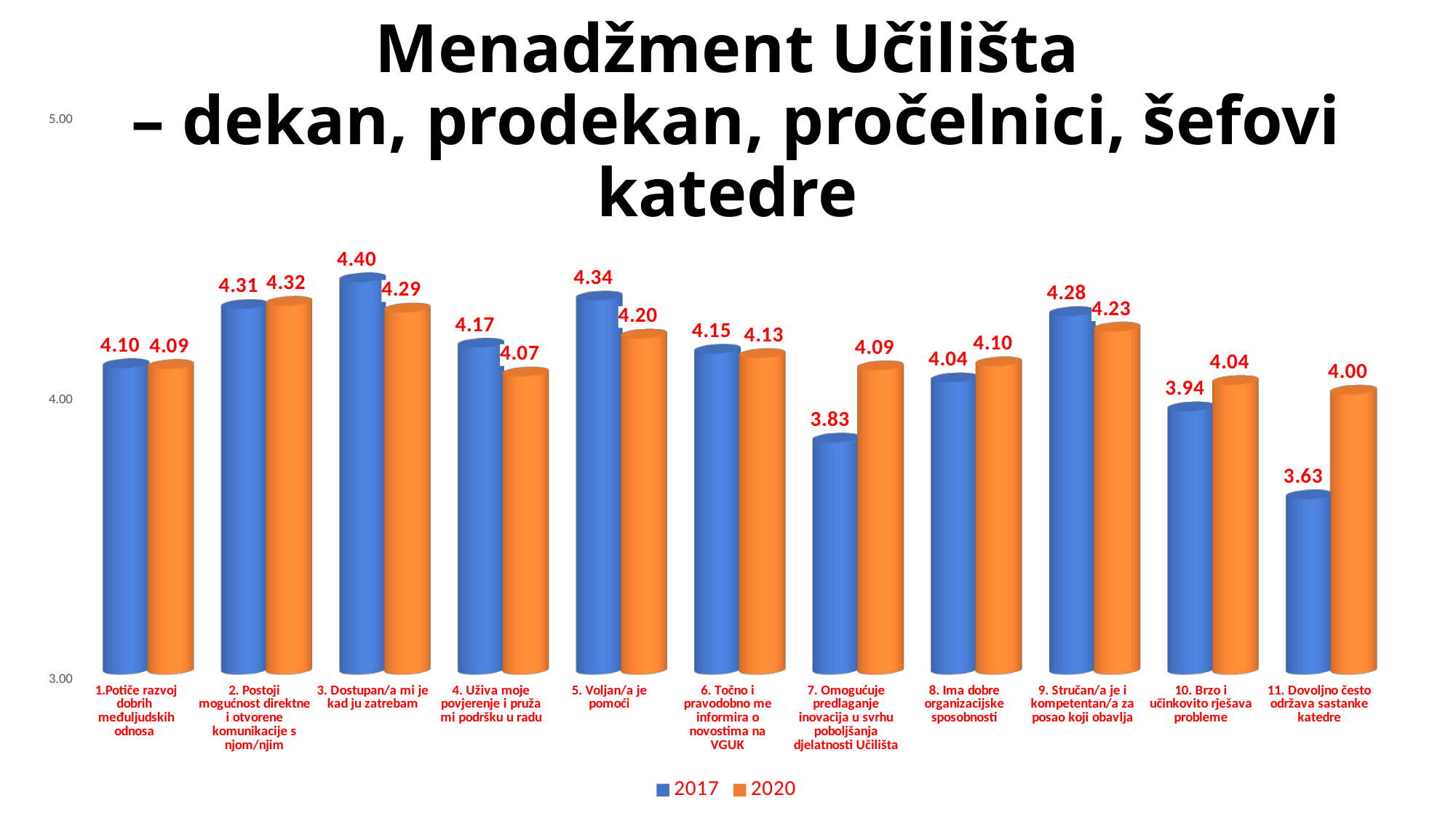
What is the difference between the 2020 and 2017 values for "11. Dovoljno često održava sastanke katedre"? 0.37 Which category has the lowest 2017 value? 11. Dovoljno često održava sastanke katedre What is the 2017 value for "3. Dostupan/a mi je kad ju zatrebam"? 4.40 Which category has the highest 2017 value? 3. Dostupan/a mi je kad ju zatrebam How many categories are shown on the x axis? 11 For "7. Omogućuje predlaganje inovacija u svrhu poboljšanja djelatnosti Učilišta", which year has the larger value, 2017 or 2020? 2020 Which category has the highest 2020 value? 2. Postoji mogućnost direktne i otvorene komunikacije s njom/njim What is the 2020 value for "11. Dovoljno često održava sastanke katedre"? 4.00 How many series does the legend list? 2 What is the 2017 value for "7. Omogućuje predlaganje inovacija u svrhu poboljšanja djelatnosti Učilišta"? 3.83 What kind of chart is shown on the slide? Bar chart What is the difference between the 2017 and 2020 values for "5. Voljan/a je pomoći"? 0.14